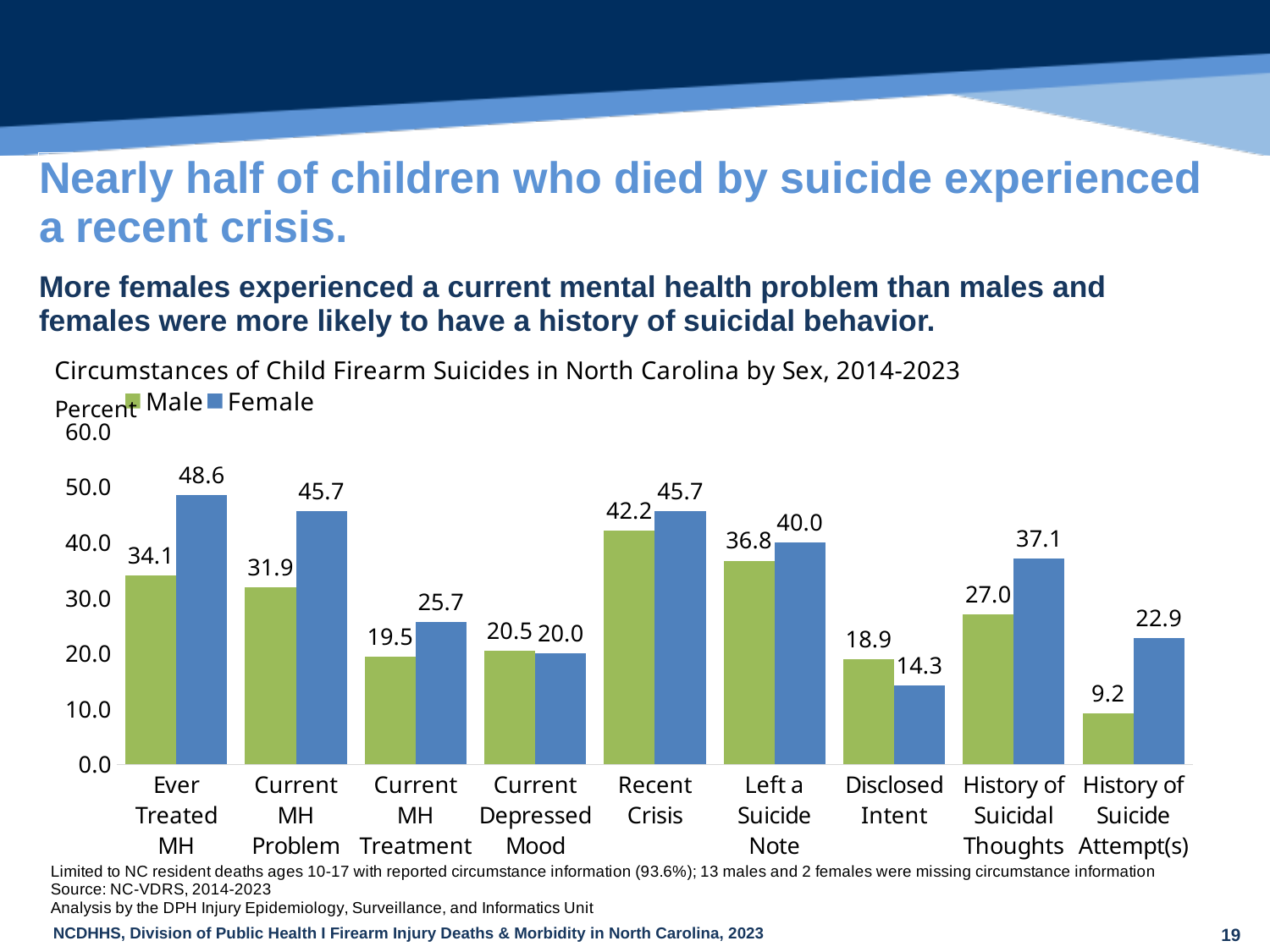
For Disclosed Intent, which is larger, the Male or the Female value? Male What is the title of the chart? Circumstances of Child Firearm Suicides in North Carolina by Sex, 2014-2023 Which category has the lowest Female value? Disclosed Intent How many series does the legend list? 2 What is the difference between the Female and Male values for History of Suicidal Thoughts? 10.1 Which category has the lowest Male value? History of Suicide Attempt(s) How many categories are shown on the x axis? 9 Which category has the highest Male value? Recent Crisis What is the Female value for Ever Treated MH? 48.6 What is the Female value for History of Suicide Attempt(s)? 22.9 What is the Male value for Recent Crisis? 42.2 What kind of chart is shown on the slide? Bar chart